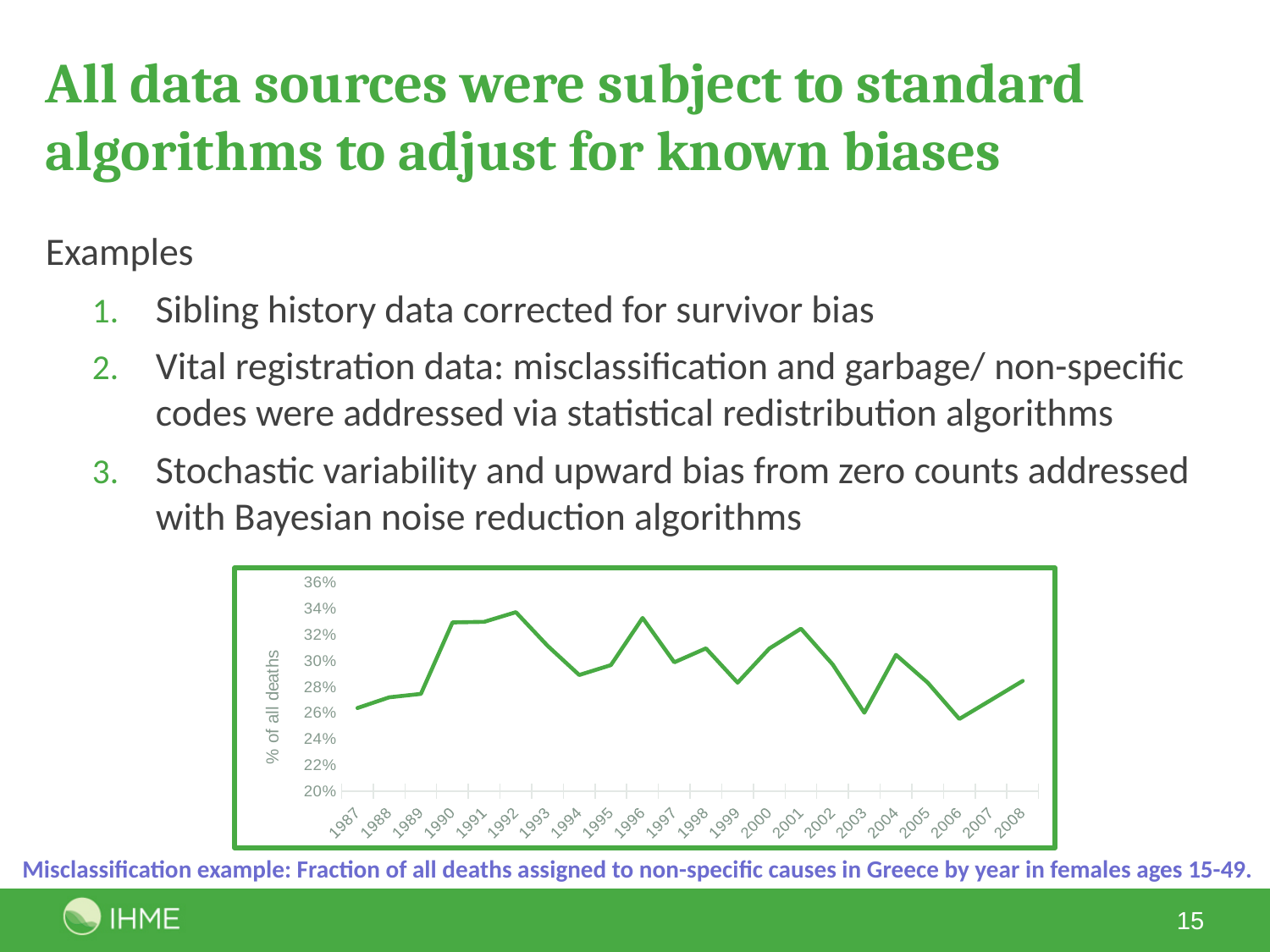
How many years are plotted along the x axis of the chart? 22 Is the value for 1990 greater or less than 30%? greater What colour is the plotted line in the chart? green Is the value for 1992 greater or less than 32%? greater Is the value for 2003 greater or less than 28%? less Which year has the larger value, 1987 or 1990? 1990 What is the label on the y axis of the chart? % of all deaths Which year has the larger value, 2001 or 2003? 2001 What kind of chart is shown on the slide? line chart Do the values rise or fall from 1987 to 1992? rise